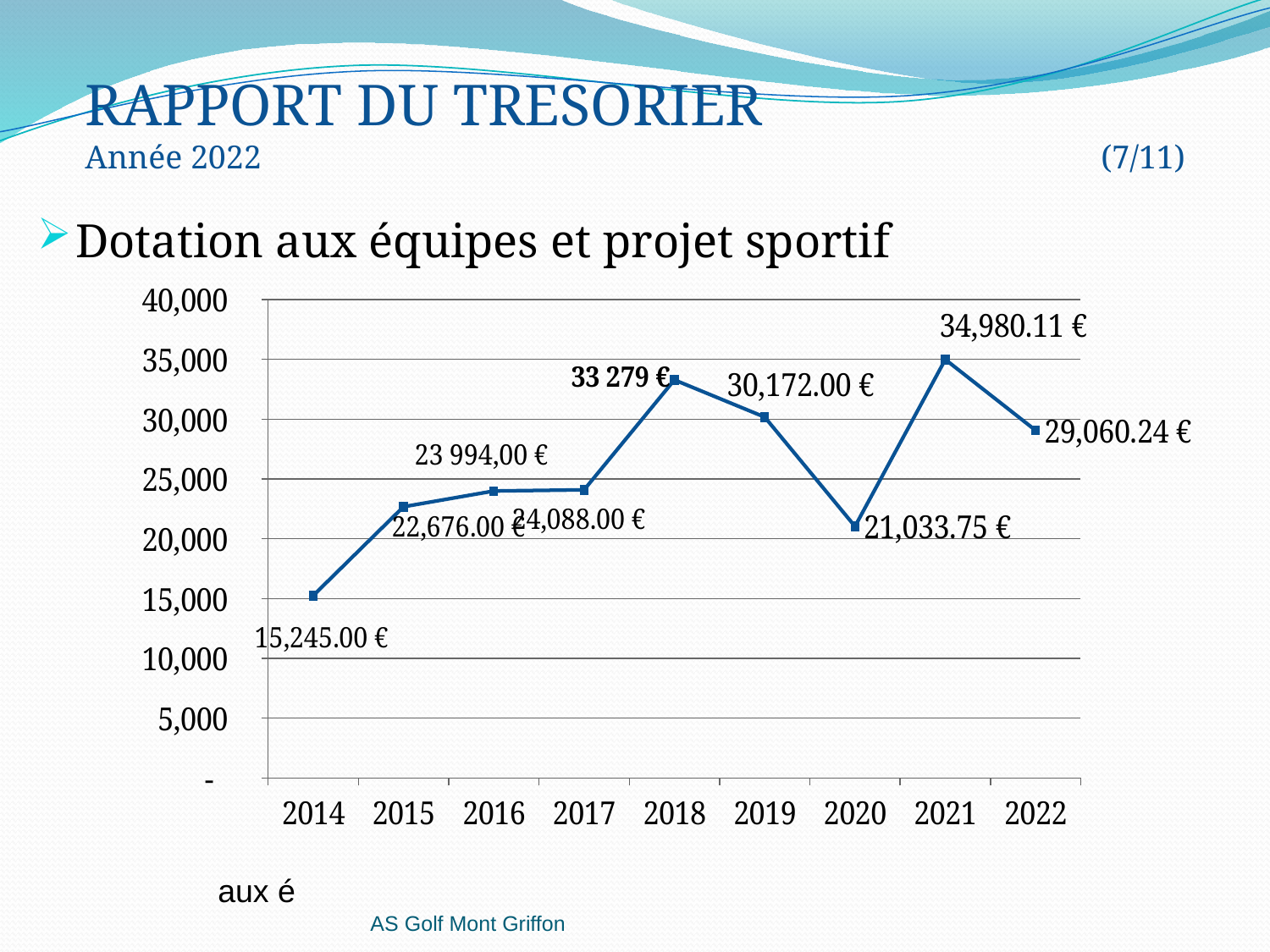
What is the value for 2020? 21,033.75 € What is the difference between the values for 2019 and 2020? 9,138.25 € What is the difference between the values for 2021 and 2022? 5,919.87 € What is the value for 2021? 34,980.11 € Is the value for 2020 greater or less than 25,000? less Which year has the highest value? 2021 How many years are plotted on the x axis? 9 What type of chart is shown on the slide? line chart What is the value for 2014? 15,245.00 € Which is larger, the value for 2018 or the value for 2019? 2018 Which year has the lowest value? 2014 What is the value for 2022? 29,060.24 €